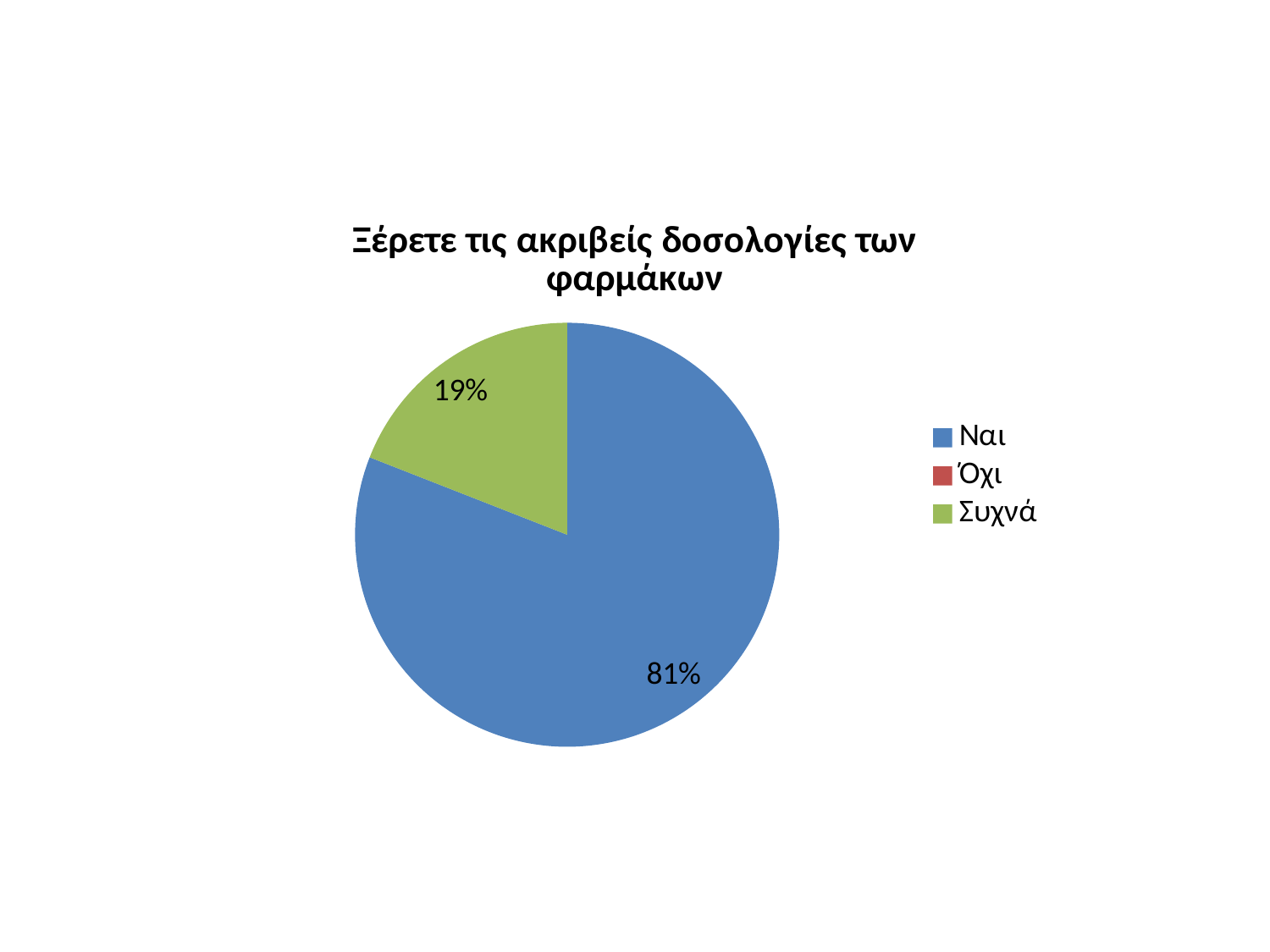
What is the title of the chart? Ξέρετε τις ακριβείς δοσολογίες των φαρμάκων Which of Ναι or Συχνά has the larger share? Ναι What share of the pie does Ναι represent? 81% What colour is the Συχνά slice? green How many entries does the legend list? 3 Is the share for Ναι greater or less than 50%? greater Which category has the largest slice of the pie? Ναι What kind of chart is shown on the slide? pie chart How many slices are visible in the pie? 2 What is the difference in percentage points between the Ναι and Συχνά slices? 62 What share of the pie does Συχνά represent? 19%